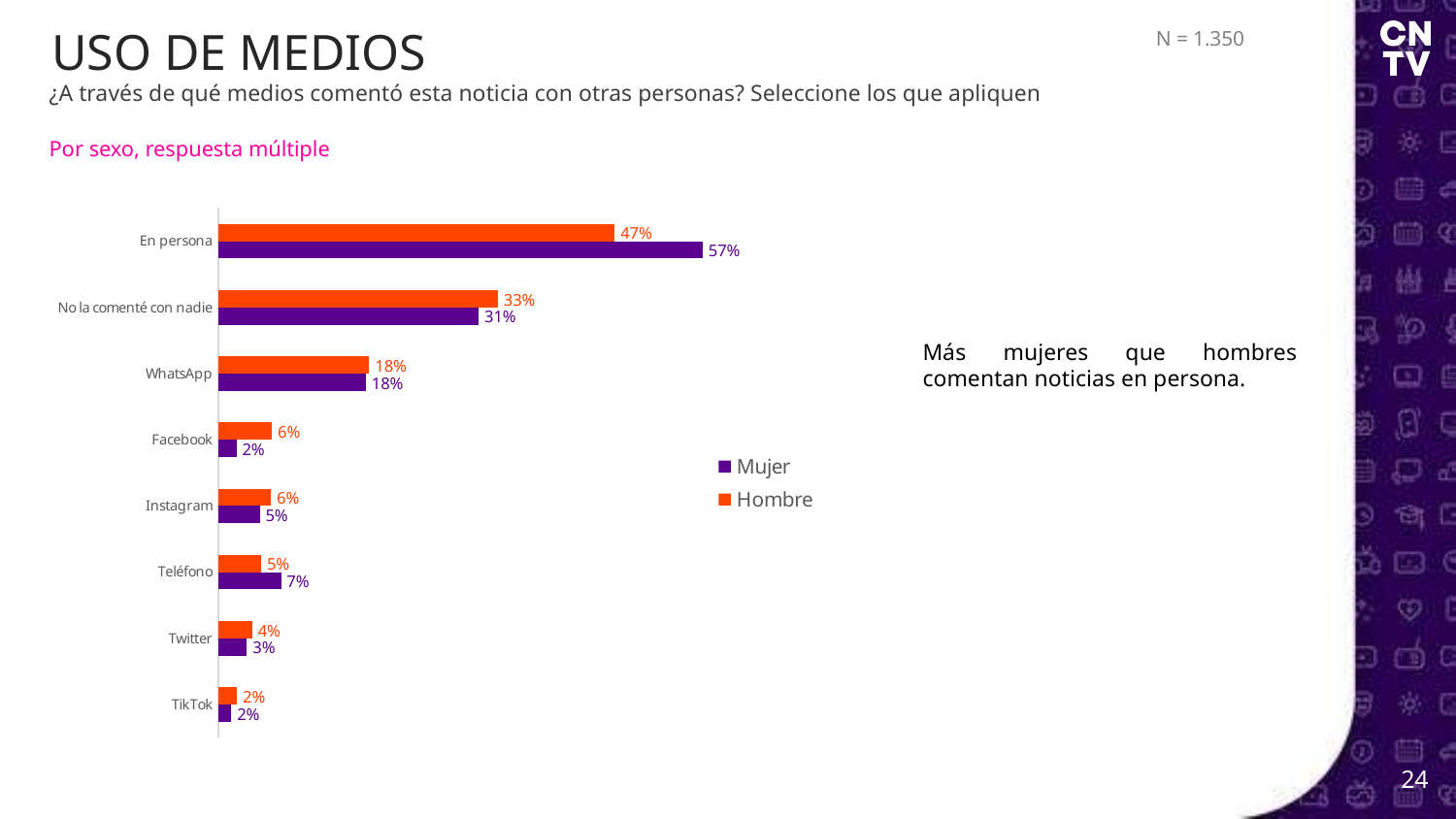
What kind of chart is shown on the slide? Bar chart Which is larger for Facebook, the Mujer value or the Hombre value? Hombre What is the difference between the Hombre and Mujer values for Instagram? 1% How many series does the legend list? 2 What is the value for Mujer for Teléfono? 7% Which category has the lowest value for Hombre? TikTok What is the difference between the Mujer and Hombre values for En persona? 10% How many categories are shown on the chart? 8 Which category has the highest value for Mujer? En persona What is the value for Mujer for En persona? 57% Which colour represents the Mujer series in the legend? Purple What is the value for Hombre for No la comenté con nadie? 33%